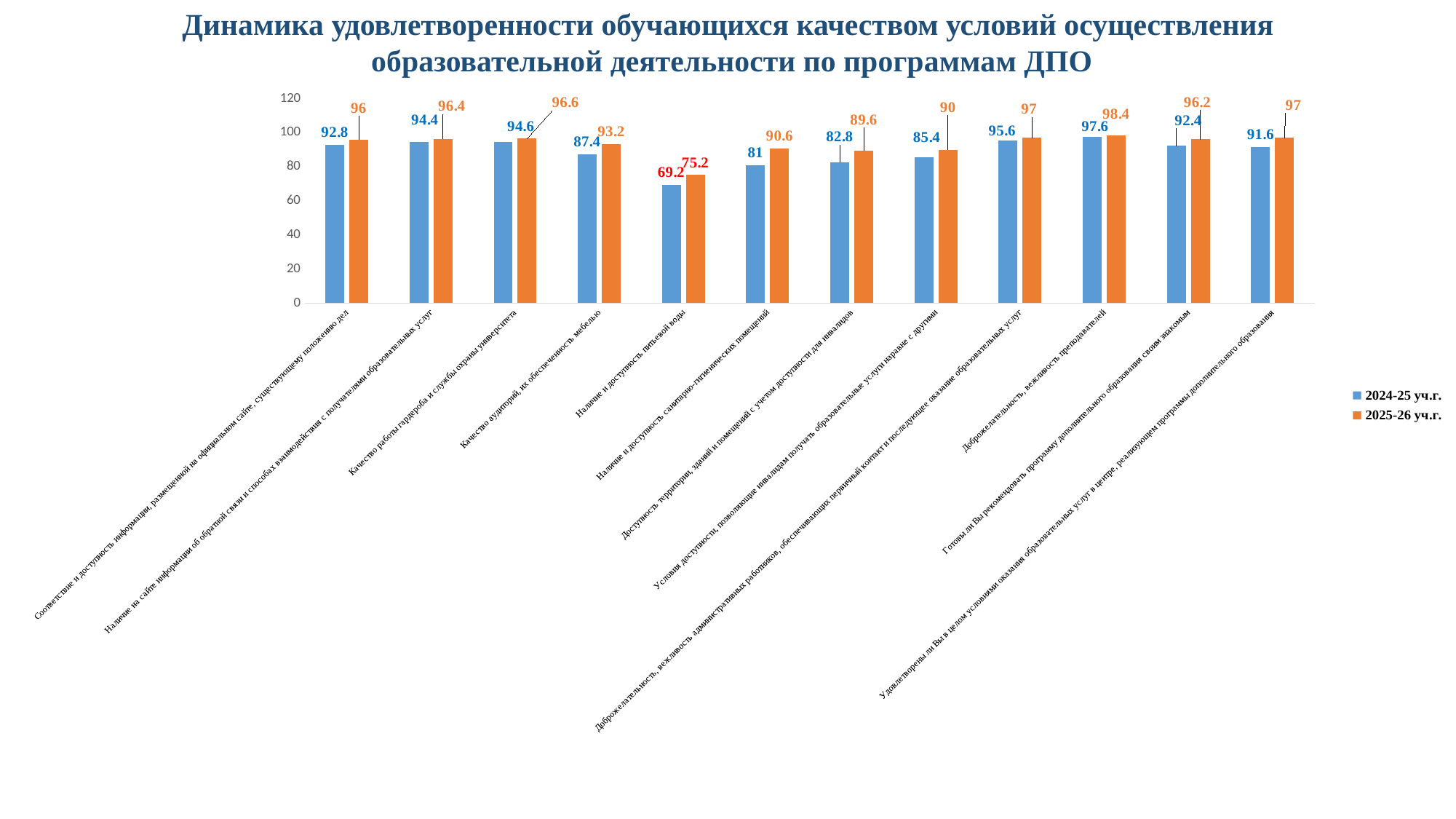
Which is larger for "Доступность территории, зданий и помещений с учетом доступности для инвалидов": the 2024-25 уч.г. value or the 2025-26 уч.г. value? 2025-26 уч.г. How many categories are shown on the x axis? 12 What type of chart is shown on the slide? Bar chart What is the difference between the 2025-26 уч.г. and 2024-25 уч.г. values for "Наличие и доступность санитарно-гигиенических помещений"? 9.6 What colour are the bars for the 2025-26 уч.г. series? Orange Which category has the highest value for 2025-26 уч.г.? Доброжелательность, вежливость преподавателей What is the value for 2024-25 уч.г. for "Наличие и доступность питьевой воды"? 69.2 What is the value for 2025-26 уч.г. for "Доброжелательность, вежливость преподавателей"? 98.4 Is the 2024-25 уч.г. value for "Наличие и доступность питьевой воды" greater or less than 80? less Which category has the lowest value for 2024-25 уч.г.? Наличие и доступность питьевой воды What is the value for 2025-26 уч.г. for "Качество аудиторий, их обеспеченность мебелью"? 93.2 How many series does the legend list? 2